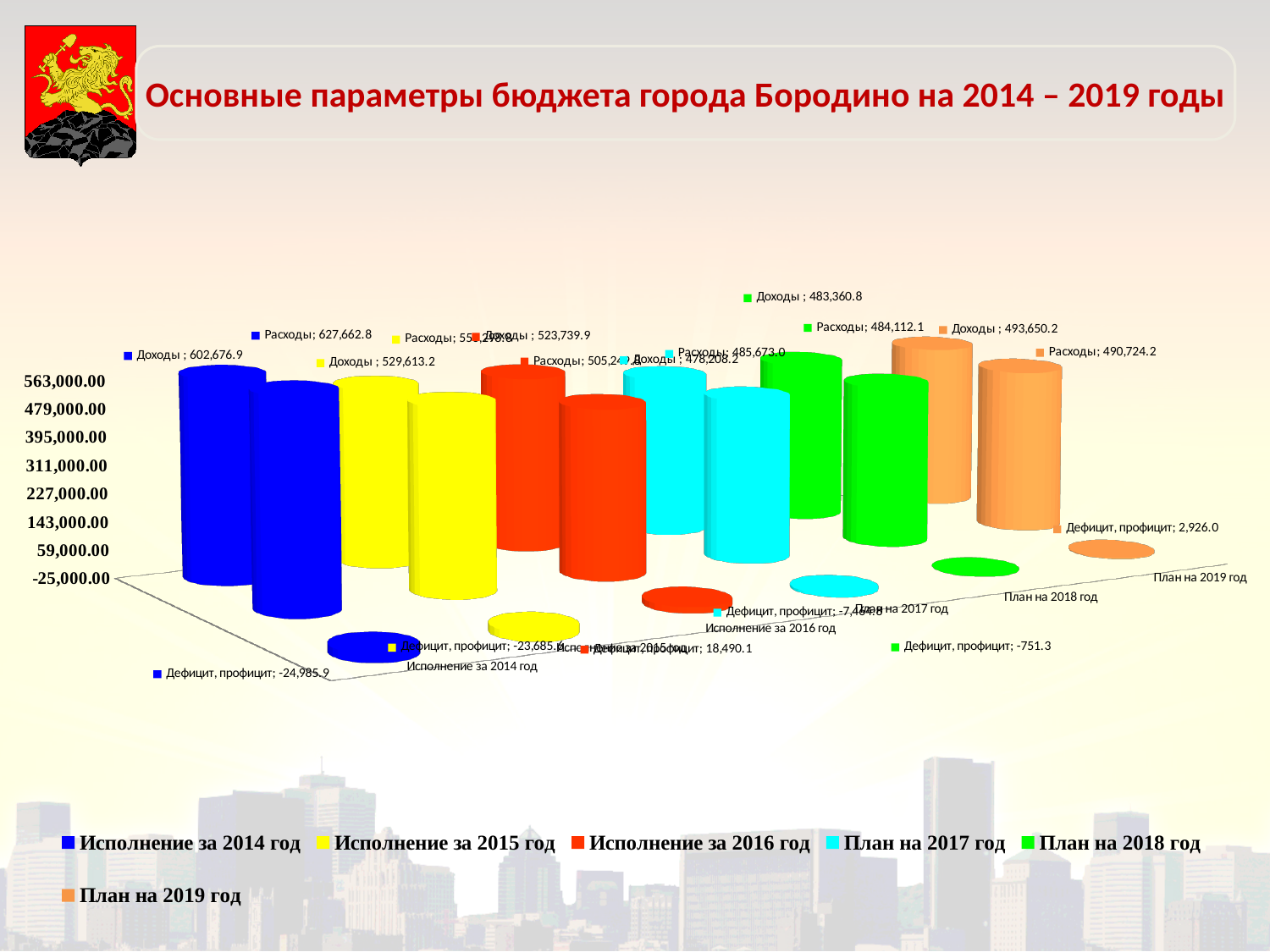
What is the difference between Расходы and Доходы for Исполнение за 2014 год? 24,985.9 What is the value of Расходы for Исполнение за 2014 год? 627,662.8 What is the value of Доходы for План на 2019 год? 493,650.2 What is the value of Дефицит, профицит for План на 2019 год? 2,926.0 What is the value of Расходы for План на 2018 год? 484,112.1 Which is larger: Доходы for План на 2018 год or Доходы for План на 2017 год? План на 2018 год What is the value of Дефицит, профицит for План на 2018 год? -751.3 What is the value of Доходы for Исполнение за 2014 год? 602,676.9 What is the title of the slide? Основные параметры бюджета города Бородино на 2014 – 2019 годы Which series has the highest value for Доходы? Исполнение за 2014 год How many series does the legend list? 6 What kind of chart is shown on the slide? bar chart